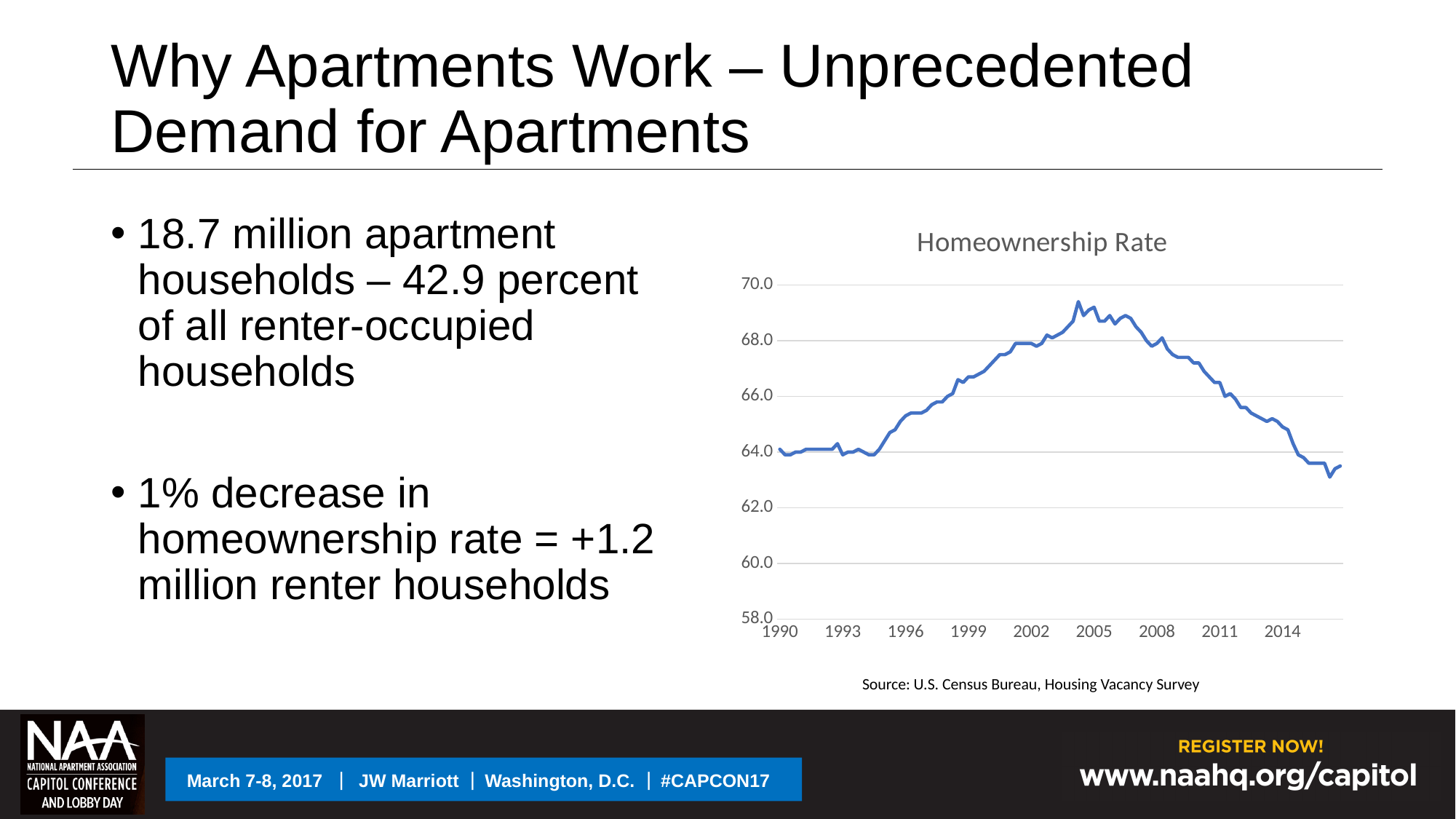
Around which year labelled on the x axis does the homeownership rate reach its peak? 2005 Does the homeownership rate rise or fall between 2005 and 2014? fall Is the homeownership rate in 1996 greater or less than 66.0? less How many year labels are shown on the x axis of the chart? 9 Is the lowest point of the homeownership rate line greater or less than 64.0? less Is the homeownership rate in 1999 greater or less than 66.0? greater Does the homeownership rate rise or fall between 1990 and 2005? rise What is the title of the chart? Homeownership Rate What kind of chart is shown on the slide? line chart What is the source cited below the chart? U.S. Census Bureau, Housing Vacancy Survey